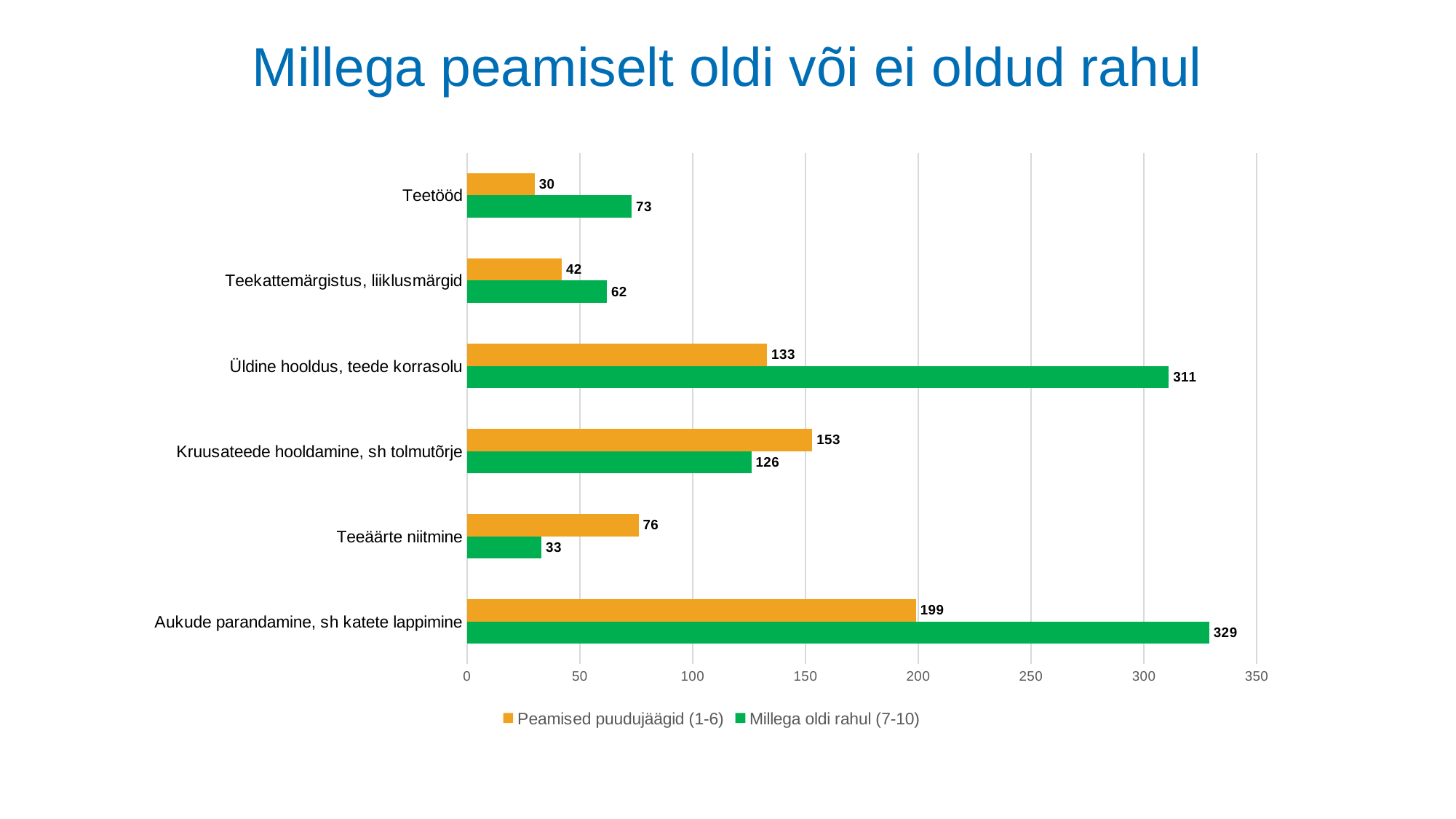
Which category has the lowest value in the "Peamised puudujäägid (1-6)" series? Teetööd What kind of chart is shown on the slide? Bar chart What is the value for "Teeäärte niitmine" in the "Millega oldi rahul (7-10)" series? 33 Is the "Peamised puudujäägid (1-6)" value for "Aukude parandamine, sh katete lappimine" greater or less than 150? greater Which category has the highest value in the "Millega oldi rahul (7-10)" series? Aukude parandamine, sh katete lappimine What is the title of the chart? Millega peamiselt oldi või ei oldud rahul What is the value for "Teetööd" in the "Millega oldi rahul (7-10)" series? 73 How many categories are shown on the chart? 6 For "Teekattemärgistus, liiklusmärgid", which series has the larger value? Millega oldi rahul (7-10) What is the value for "Kruusateede hooldamine, sh tolmutõrje" in the "Peamised puudujäägid (1-6)" series? 153 How many series does the legend list? 2 What is the difference between the "Millega oldi rahul (7-10)" and "Peamised puudujäägid (1-6)" values for "Üldine hooldus, teede korrasolu"? 178